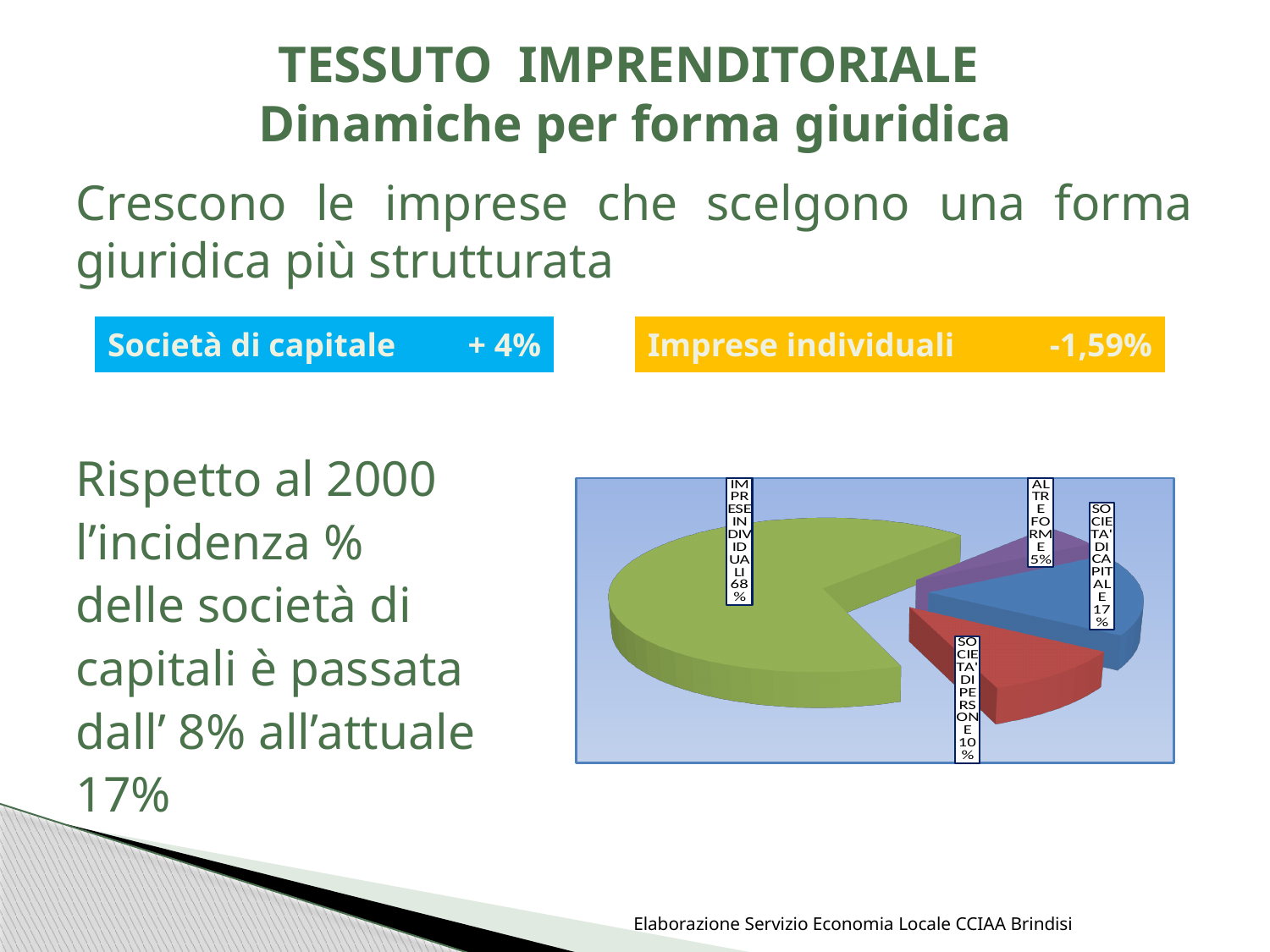
In the pie chart, which is larger: SOCIETA' DI CAPITALE or SOCIETA' DI PERSONE? SOCIETA' DI CAPITALE What share of the pie chart is labelled SOCIETA' DI PERSONE? 10% In the pie chart, what is the difference in percentage points between IMPRESE INDIVIDUALI and SOCIETA' DI CAPITALE? 51 What colour is the IMPRESE INDIVIDUALI slice in the pie chart? Green Which slice of the pie chart is the largest? IMPRESE INDIVIDUALI What kind of chart is shown on the slide? Pie chart In the pie chart, what is the combined share of SOCIETA' DI CAPITALE and SOCIETA' DI PERSONE? 27% Which slice of the pie chart is the smallest? ALTRE FORME What share of the pie chart is labelled SOCIETA' DI CAPITALE? 17% What share of the pie chart is labelled ALTRE FORME? 5% How many slices does the pie chart have? 4